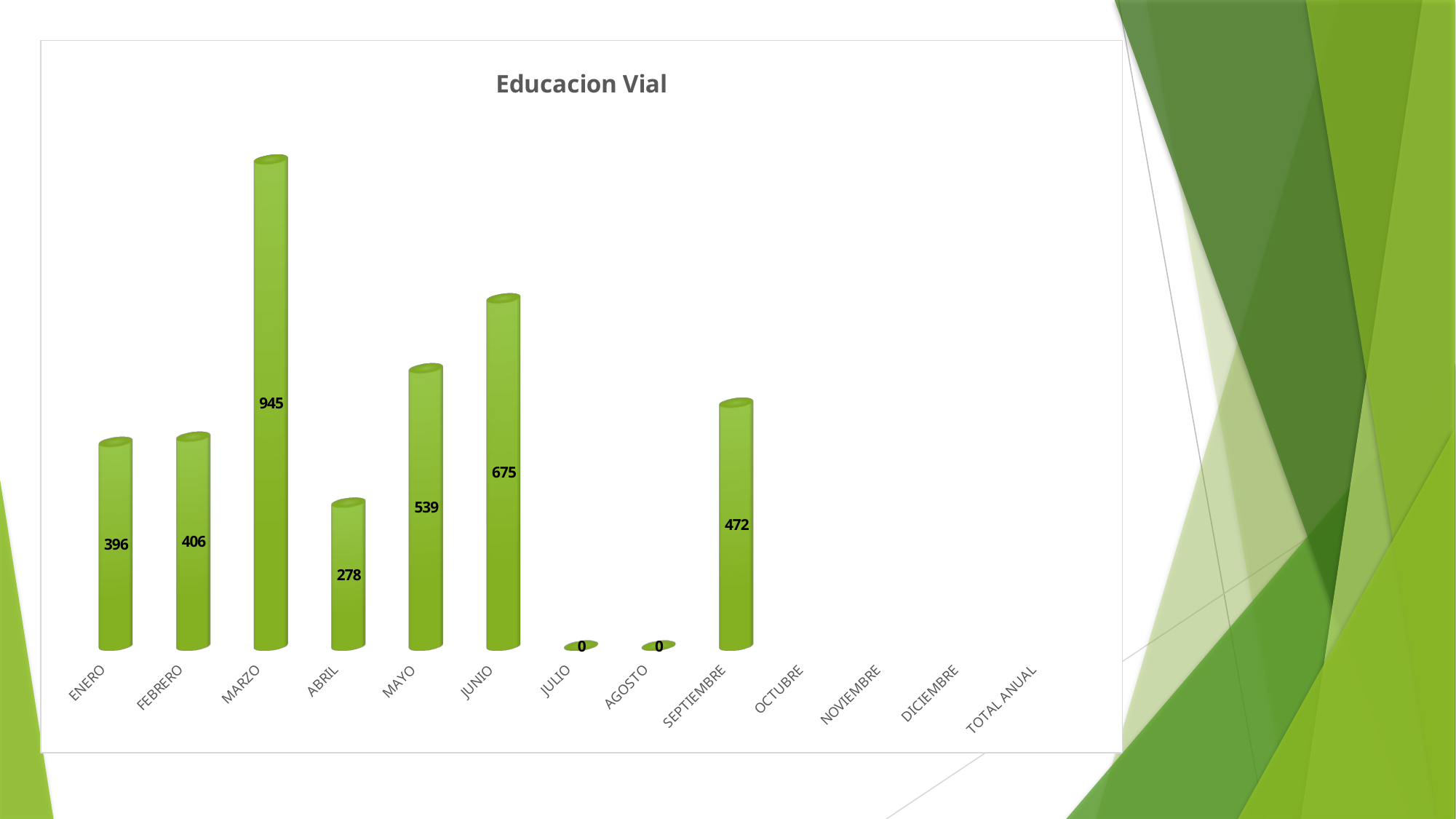
What is the value for ABRIL? 278 What value is shown for JULIO? 0 What is the difference between the values for MARZO and ENERO? 549 What is the value for MARZO? 945 Which is larger, the value for FEBRERO or the value for ENERO? FEBRERO What is the title of the chart? Educacion Vial What is the difference between the values for JUNIO and MAYO? 136 Which month has the highest value? MARZO What kind of chart is this? bar chart What is the value for SEPTIEMBRE? 472 How many categories are shown on the x axis? 13 Which is larger, the value for SEPTIEMBRE or the value for MAYO? MAYO